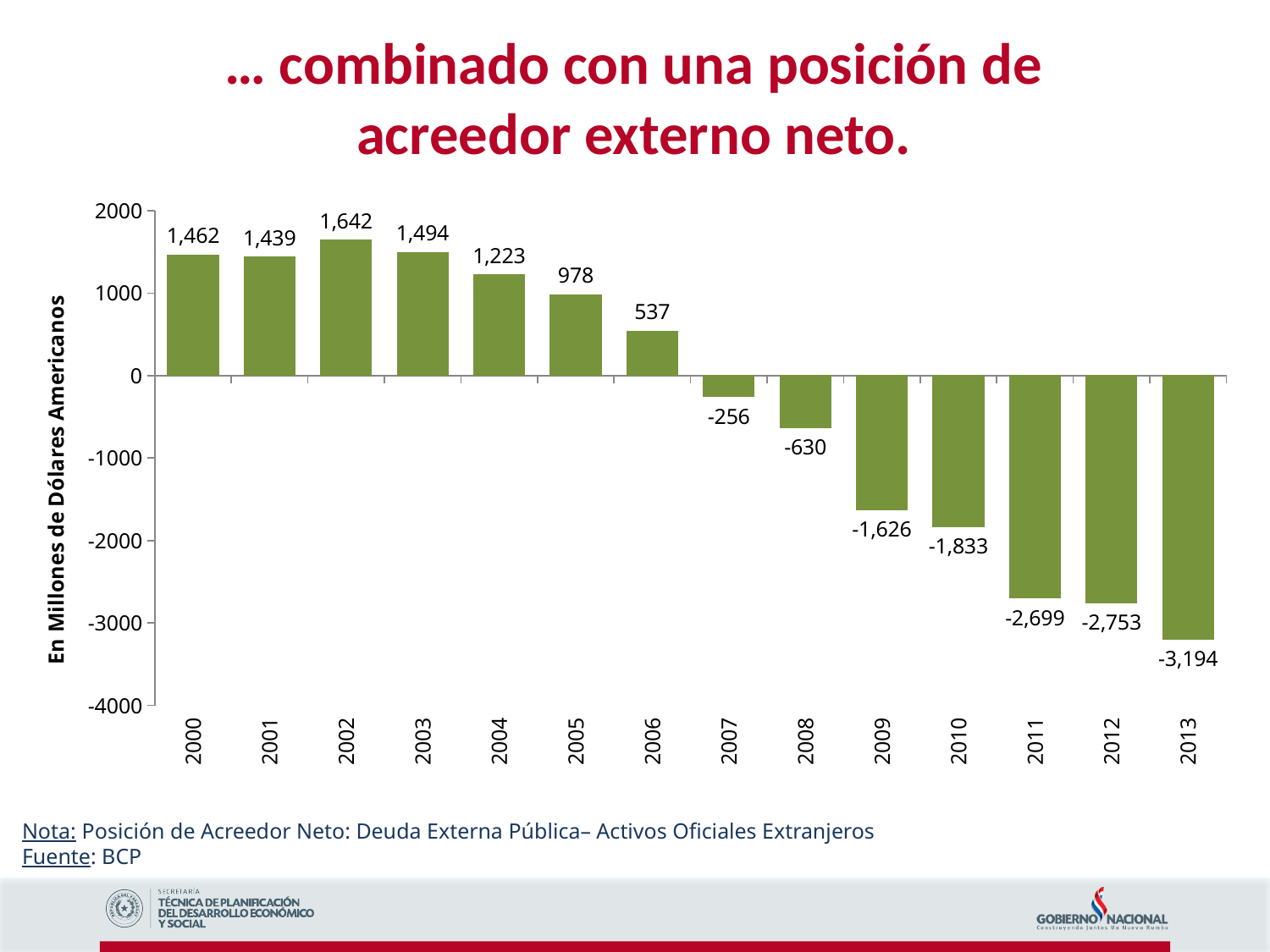
How many years are shown on the x axis? 14 Which year has the lowest value? 2013 What is the value for 2007? -256 What is the value for 2013? -3,194 Do the values rise or fall from 2002 to 2013? Fall Which is larger, the value for 2005 or the value for 2006? 2005 What is the value for 2002? 1,642 Which year has the highest value? 2002 What kind of chart is this? Bar chart What is the difference between the values for 2012 and 2013? 441 What is the difference between the values for 2000 and 2001? 23 What is the label of the vertical axis? En Millones de Dólares Americanos